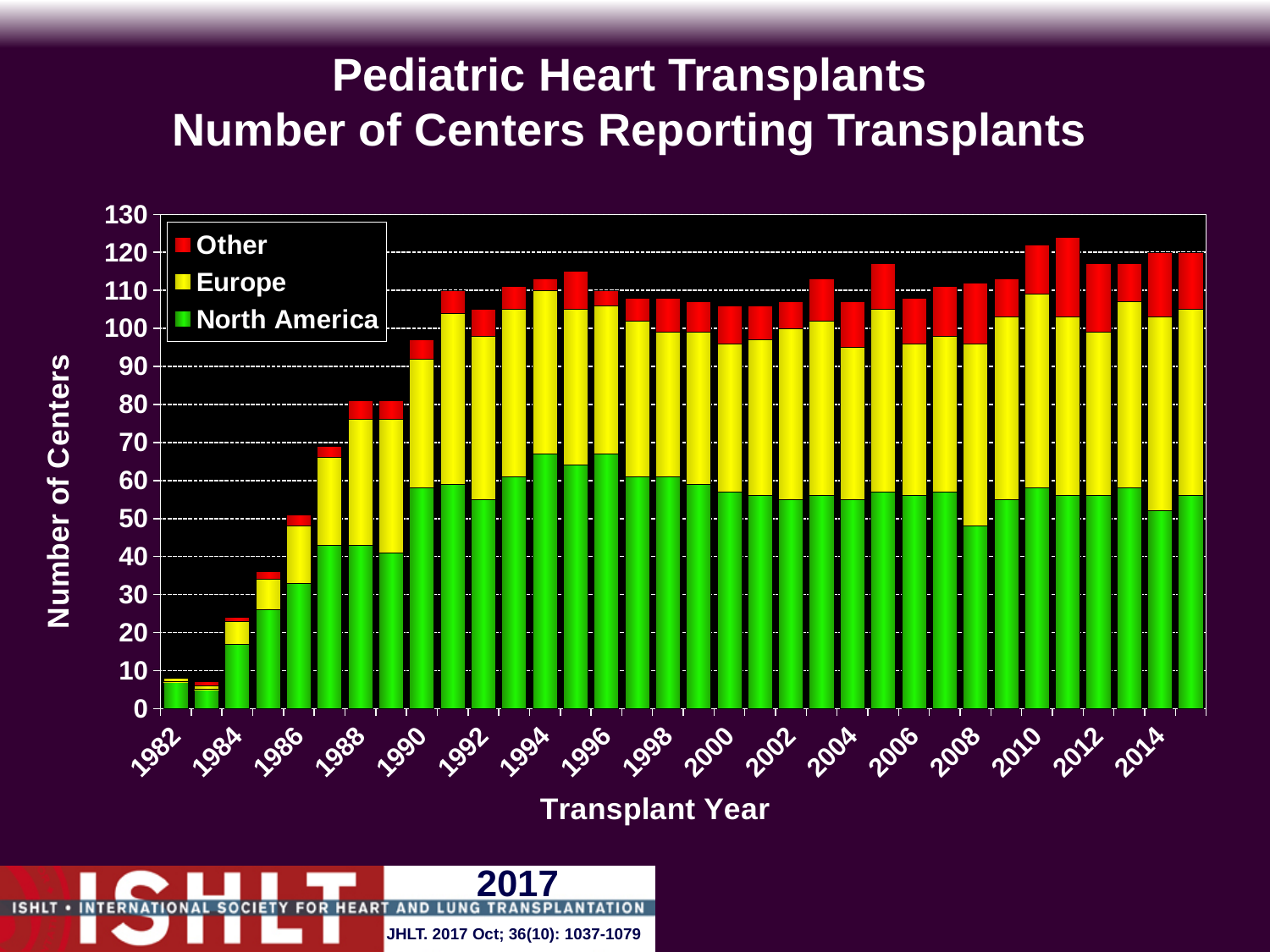
Which year has a taller total bar, 1995 or 2000? 1995 How many yearly bars are plotted in the chart? 34 Does the total number of centers rise or fall from 1982 to 1990? Rise Is the total number of centers for 1986 greater or less than 60? less Which colour represents North America in the chart? Green Is the total number of centers for 2011 greater or less than 120? greater Is the total number of centers for 1990 greater or less than 90? greater Which year has a taller total bar, 1986 or 1990? 1990 How many series does the legend list? 3 What kind of chart is shown on the slide? Stacked bar chart